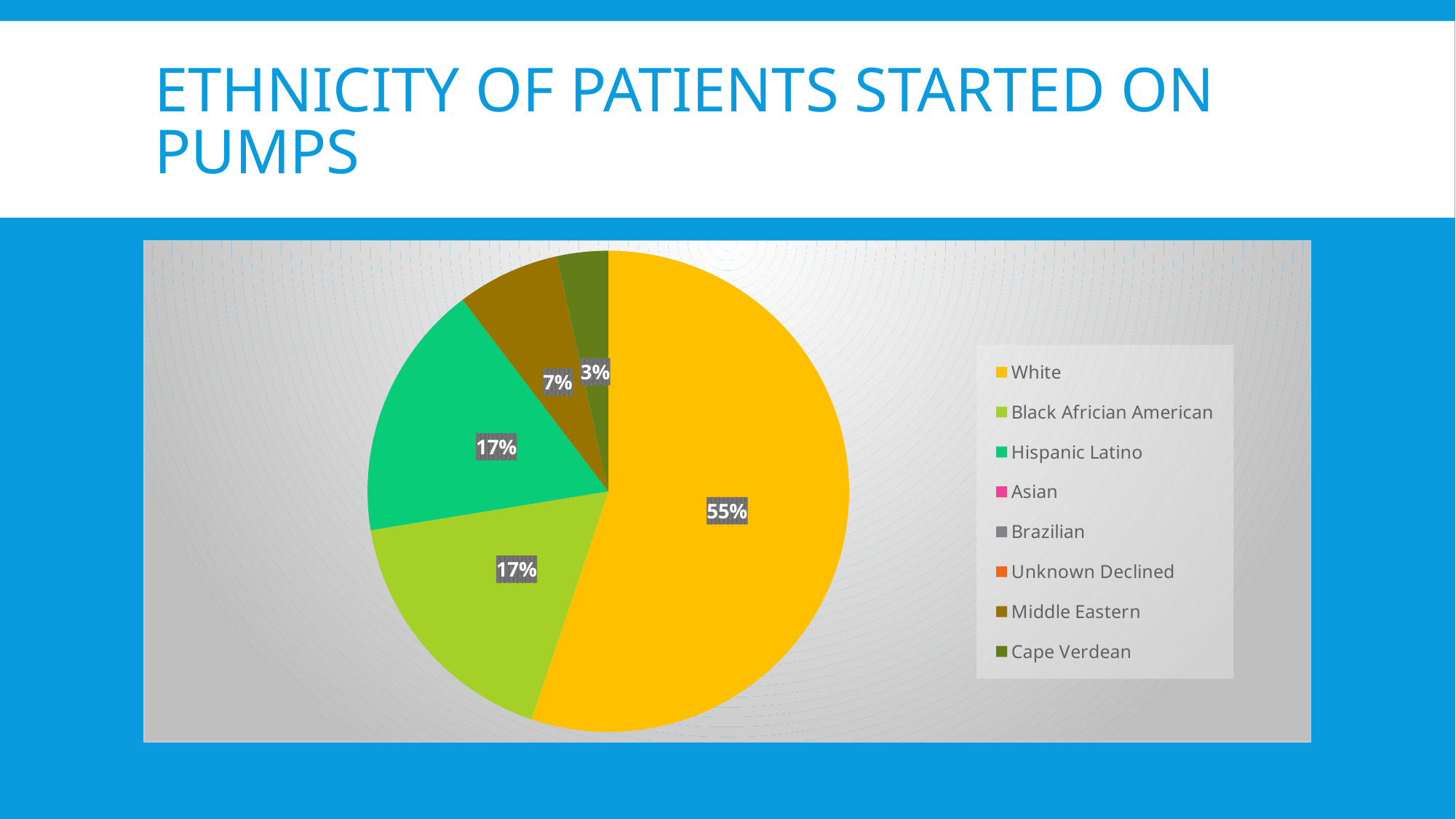
What percentage of patients started on pumps are Cape Verdean? 3% Which ethnicity has the largest share of the pie? White Which labelled slice of the pie is the smallest? Cape Verdean Which slice is larger, Middle Eastern or Cape Verdean? Middle Eastern What percentage of patients started on pumps are Hispanic Latino? 17% How many ethnicity categories are listed in the legend? 8 What is the title of the slide? Ethnicity of Patients Started on Pumps What percentage of patients started on pumps are White? 55% What percentage of patients started on pumps are Black Africian American? 17% What percentage of patients started on pumps are Middle Eastern? 7% What is the difference in percentage points between the White slice and the Hispanic Latino slice? 38 What type of chart is shown on the slide? Pie chart